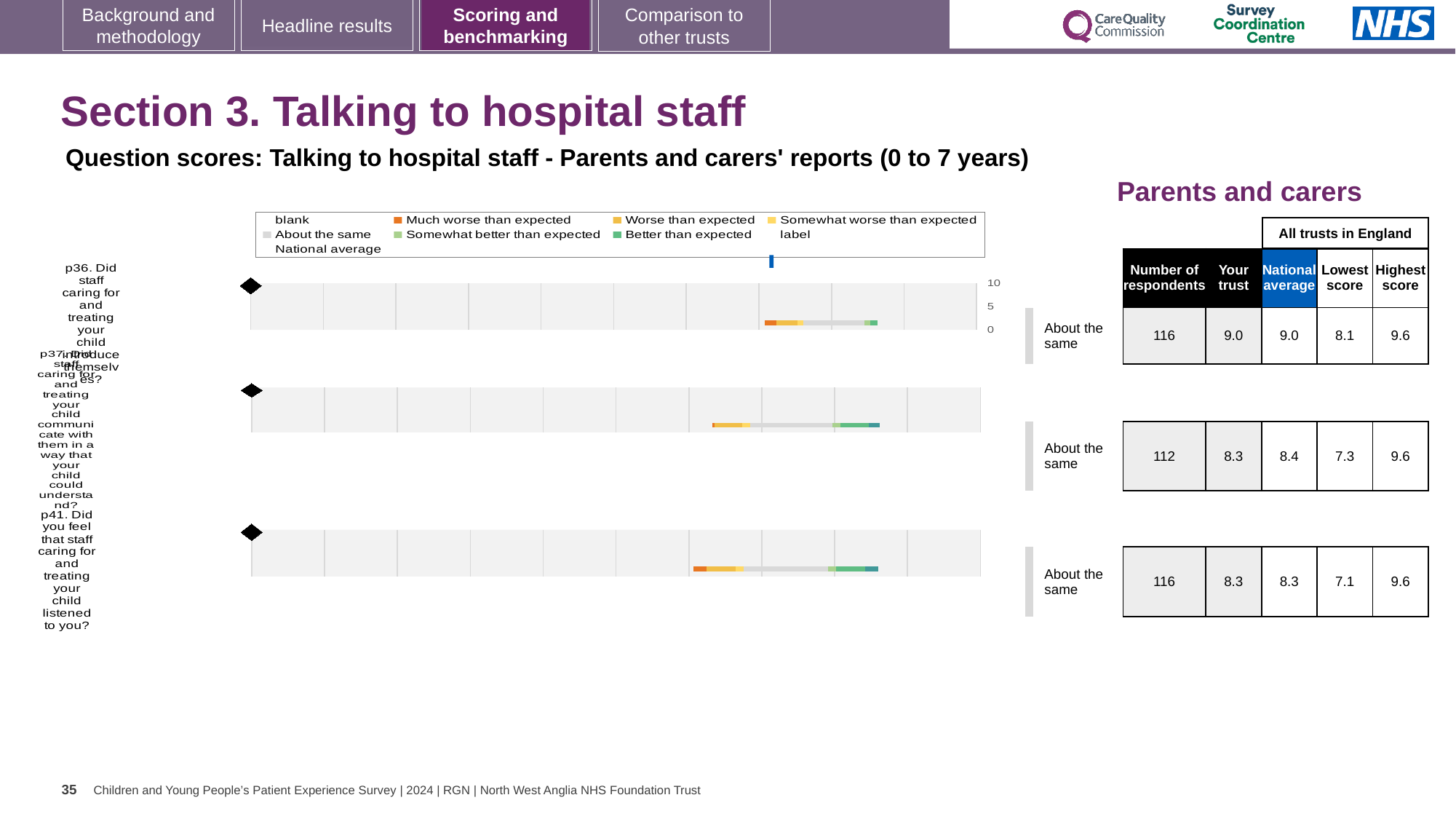
Which is larger, the national average for p37 or the national average for p41? p37 What benchmark category is shown for all three questions? About the same How many survey questions are plotted in the chart? 3 Is the trust's score for p36 greater or less than 5 on the chart axis? greater Which question has the highest 'Your trust' score? p36 What colour does the legend use for 'Much worse than expected'? orange What is the maximum value shown on the chart's score axis? 10 What is the difference between the highest score and the lowest score for p36? 1.5 What is the 'Your trust' score for p36 (Did staff caring for and treating your child introduce themselves)? 9.0 How many respondents answered p37 (Did staff communicate with them in a way that your child could understand)? 112 What is the lowest score across all trusts in England for p41 (Did you feel that staff listened to you)? 7.1 What kind of chart is used to show the question scores on this slide? bar chart